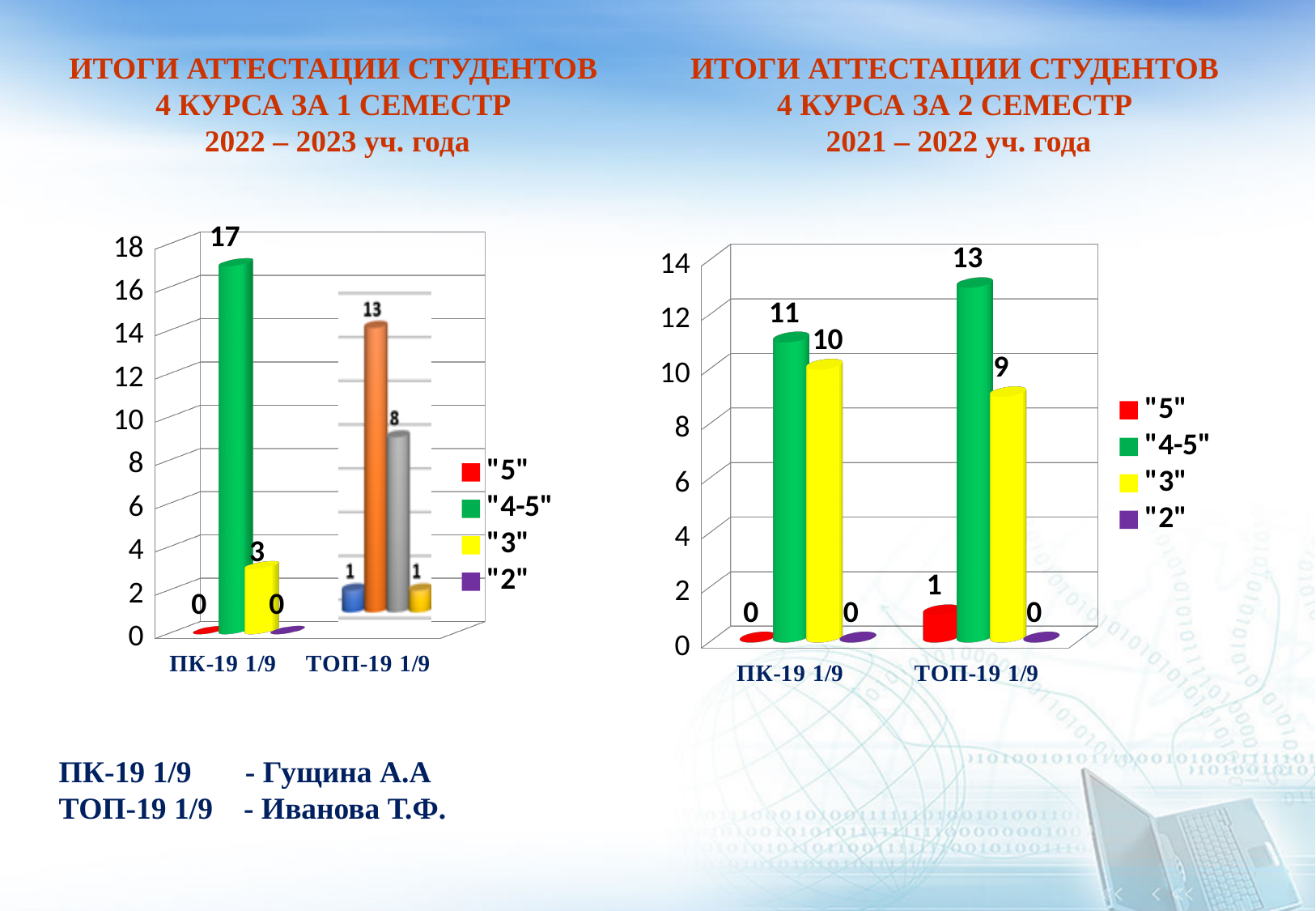
In the right chart (2 семестр 2021–2022), which series is shown in green in the legend? "4-5" In the right chart (2 семестр 2021–2022), what is the value of "3" for ПК-19 1/9? 10 In the right chart (2 семестр 2021–2022), what is the difference between the "4-5" values of ТОП-19 1/9 and ПК-19 1/9? 2 How many groups (categories) are shown on the x axis of the left chart? 2 In the right chart (2 семестр 2021–2022), which group has the higher "4-5" value? ТОП-19 1/9 How many series does the legend of the right chart list? 4 In the left chart (1 семестр 2022–2023), what is the value of "4-5" for ПК-19 1/9? 17 In the left chart (1 семестр 2022–2023), what is the difference between the "4-5" value and the "3" value for ПК-19 1/9? 14 What type of chart is the right chart (2 семестр 2021–2022)? Bar chart In the right chart (2 семестр 2021–2022), what is the value of "5" for ТОП-19 1/9? 1 In the left chart (1 семестр 2022–2023), what is the value of "3" for ПК-19 1/9? 3